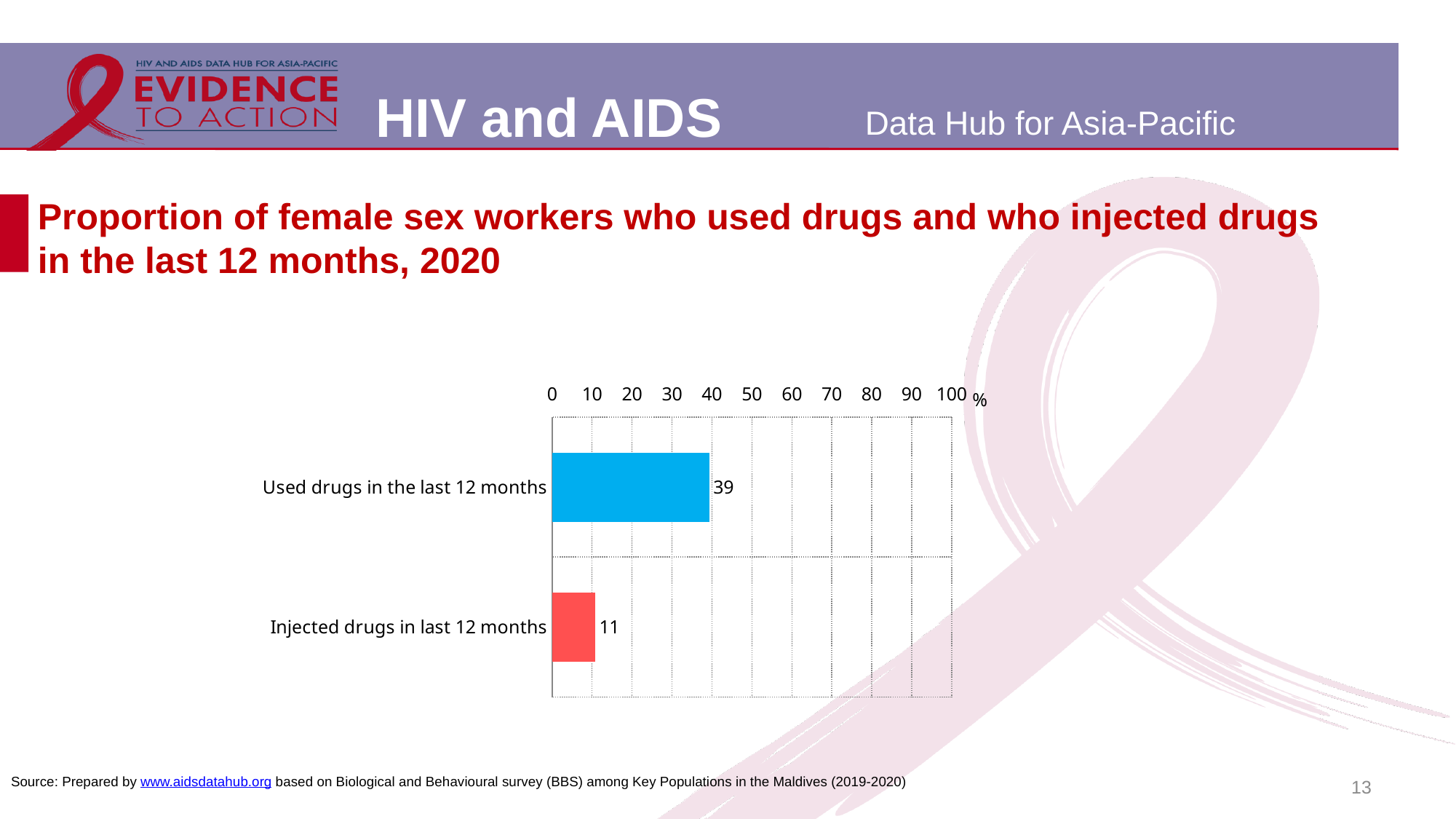
What kind of chart is shown on the slide? Bar chart Is the value for 'Used drugs in the last 12 months' greater or less than 50? less Which category has the lowest value? Injected drugs in last 12 months What is the value for 'Injected drugs in last 12 months'? 11 What is the maximum value shown on the chart's axis? 100 Is the value for 'Injected drugs in last 12 months' greater or less than 10? greater What is the difference between the value for 'Used drugs in the last 12 months' and 'Injected drugs in last 12 months'? 28 What colour is the bar for 'Injected drugs in last 12 months'? Red Which is larger: the value for 'Used drugs in the last 12 months' or 'Injected drugs in last 12 months'? Used drugs in the last 12 months What is the value for 'Used drugs in the last 12 months'? 39 How many categories are shown in the chart? 2 Which category has the highest value? Used drugs in the last 12 months